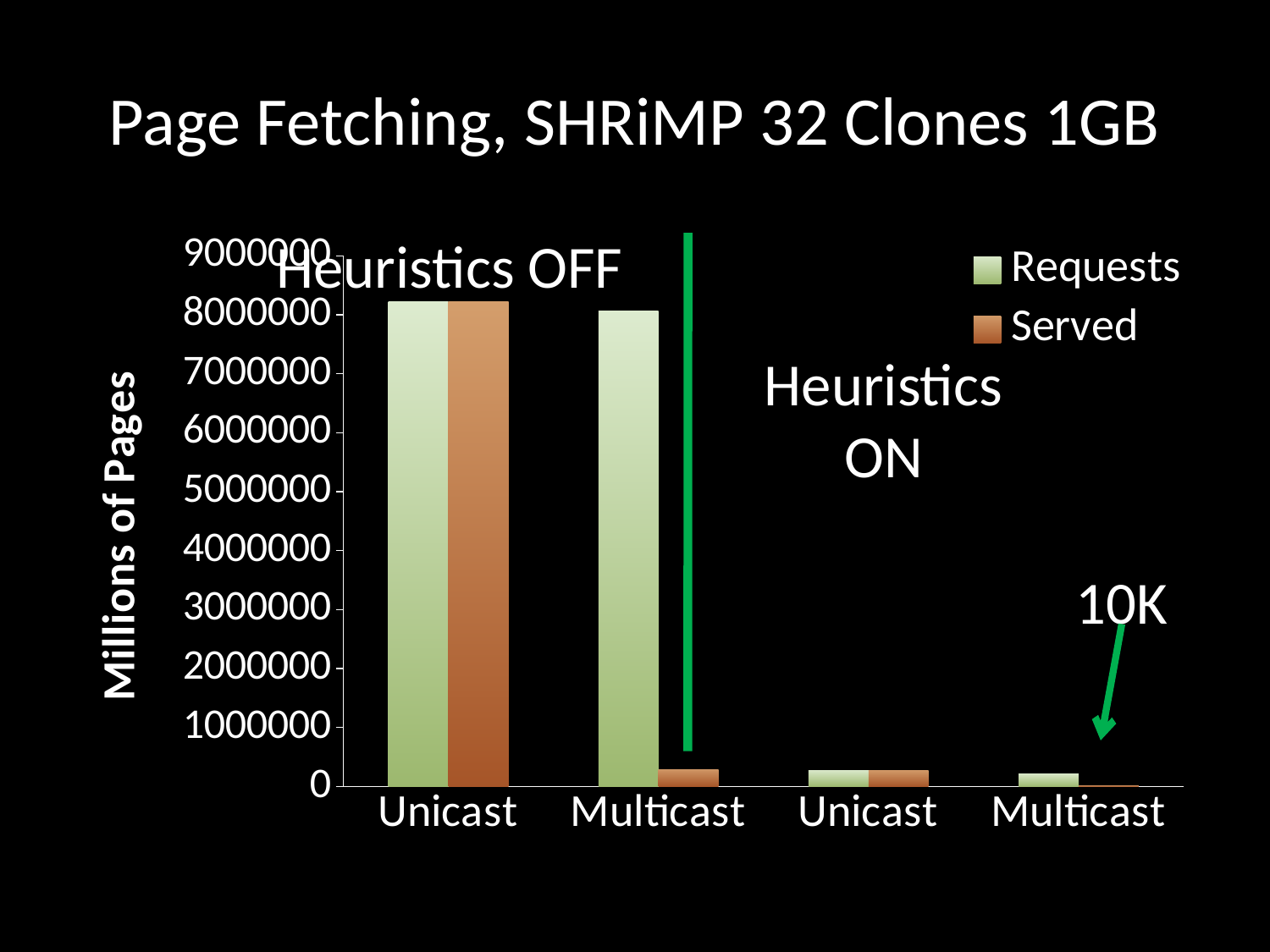
What kind of chart is shown on the slide? bar chart Is the Requests value for Unicast under Heuristics ON greater or less than 1000000? less Is the Served value for Multicast under Heuristics OFF greater or less than 1000000? less Which is larger for Multicast under Heuristics OFF, Requests or Served? Requests Is the Requests value for Multicast under Heuristics OFF greater or less than 7000000? greater How many series does the legend list? 2 Which category has the lowest Served value? Multicast under Heuristics ON How many categories are shown along the x axis? 4 Which category has the highest Served value? Unicast under Heuristics OFF What is the title of the slide's chart? Page Fetching, SHRiMP 32 Clones 1GB What are the two series named in the legend? Requests and Served